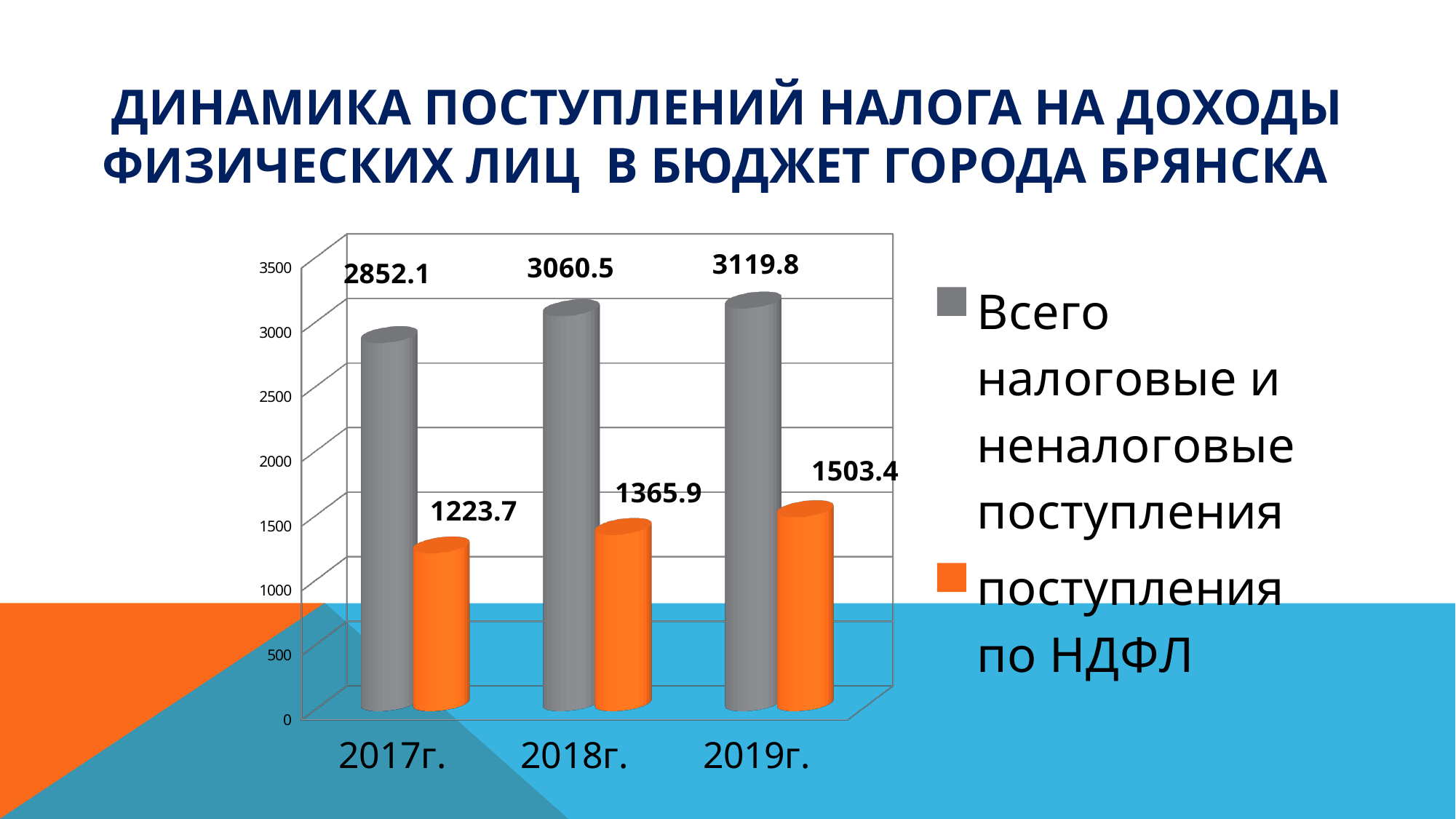
What is the difference between 'Всего налоговые и неналоговые поступления' and 'поступления по НДФЛ' in 2018г.? 1694.6 What is the value for 'поступления по НДФЛ' in 2019г.? 1503.4 What is the value for 'Всего налоговые и неналоговые поступления' in 2017г.? 2852.1 In which year is 'поступления по НДФЛ' lowest? 2017г. Which is larger: 'поступления по НДФЛ' in 2018г. or in 2019г.? 2019г. Is the value for 'Всего налоговые и неналоговые поступления' in 2018г. greater or less than 3000? greater What is the difference between 'Всего налоговые и неналоговые поступления' in 2019г. and in 2017г.? 267.7 In which year is 'Всего налоговые и неналоговые поступления' highest? 2019г. Do the values for 'поступления по НДФЛ' rise or fall from 2017г. to 2019г.? rise How many years are shown on the x axis? 3 What is the value for 'поступления по НДФЛ' in 2018г.? 1365.9 How many series does the legend list? 2